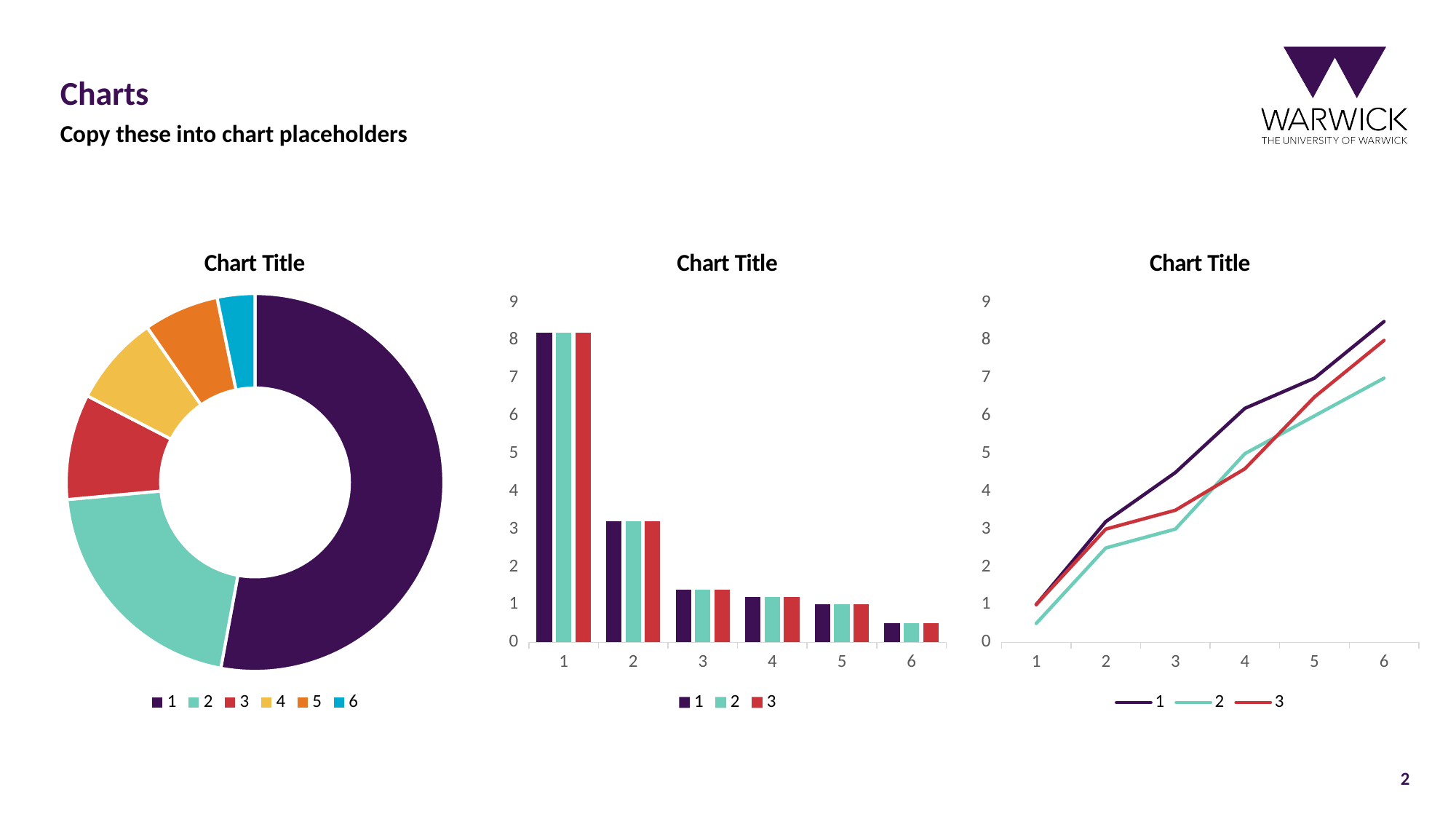
In the left doughnut chart, how many slices does the legend list? 6 In the middle bar chart, how many series does the legend list? 3 In the left doughnut chart, which legend entry has the largest slice? 1 In the left doughnut chart, which legend entry has the smallest slice? 6 In the middle bar chart, how many categories are shown on the x axis? 6 In the middle bar chart, is the value for series 1 at category 1 greater or less than 7? greater In the right line chart, do the values of series 1 rise or fall from x = 1 to x = 6? rise What kind of chart is the middle chart on the slide? bar chart In the middle bar chart, is the value for series 3 at category 6 greater or less than 1? less What kind of chart is the left chart on the slide? doughnut chart What kind of chart is the right chart on the slide? line chart In the right line chart, which series has the highest value at x = 6? 1